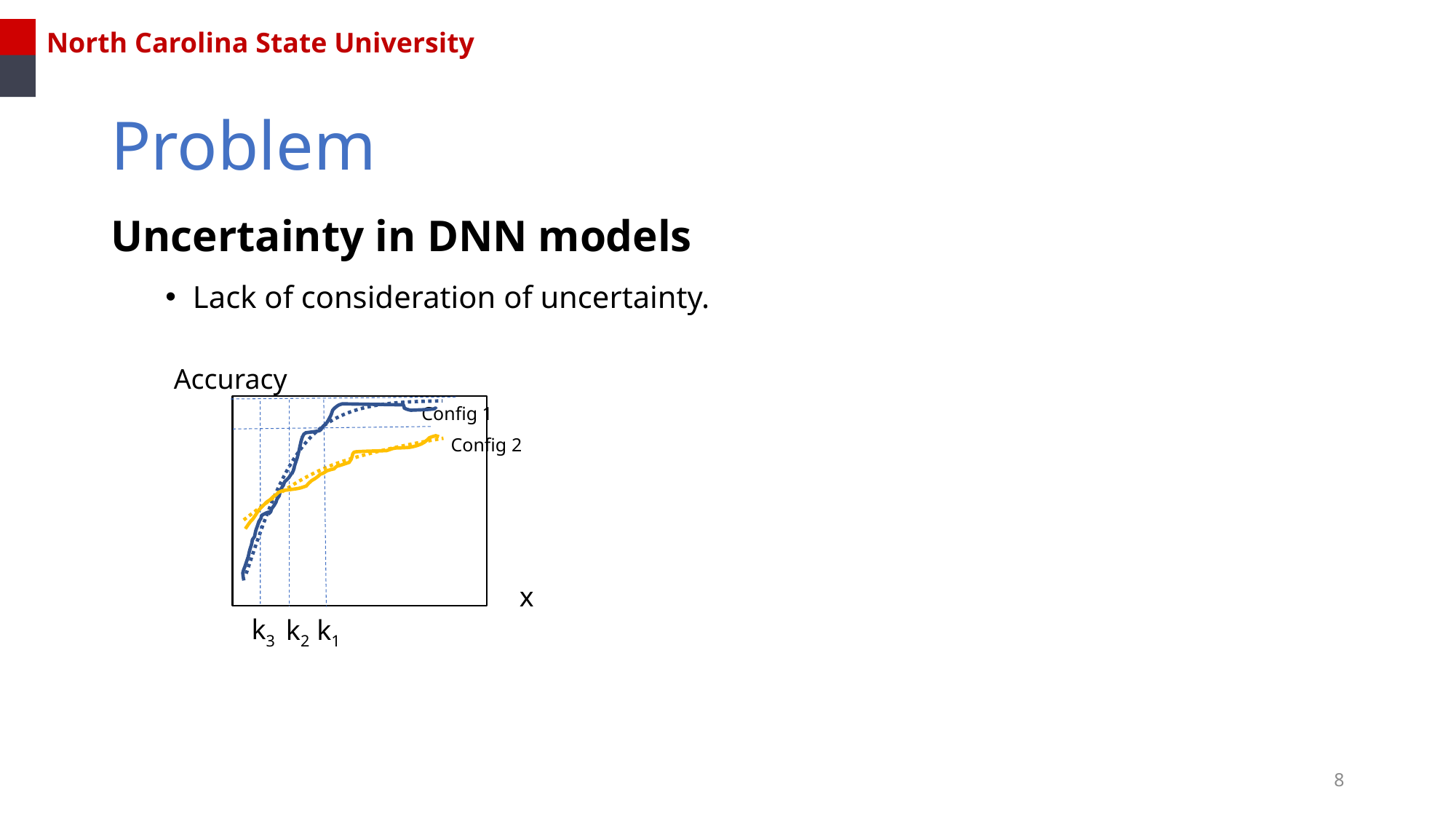
How many configurations are labelled on the chart? 2 Which configuration reaches the higher accuracy at the right end of the chart? Config 1 Which configuration is drawn in yellow? Config 2 Does the accuracy of Config 1 rise or fall as x increases? Rise How many k markers (k1, k2, k3) are shown along the x axis? 3 What is the label of the horizontal axis of the chart? x At the far left of the chart, which configuration has the higher accuracy, Config 1 or Config 2? Config 2 Does the accuracy of Config 2 rise or fall as x increases? Rise What is the label of the vertical axis of the chart? Accuracy Which configuration has the lower accuracy at the right end of the chart? Config 2 What kind of chart is shown on the slide? Line chart